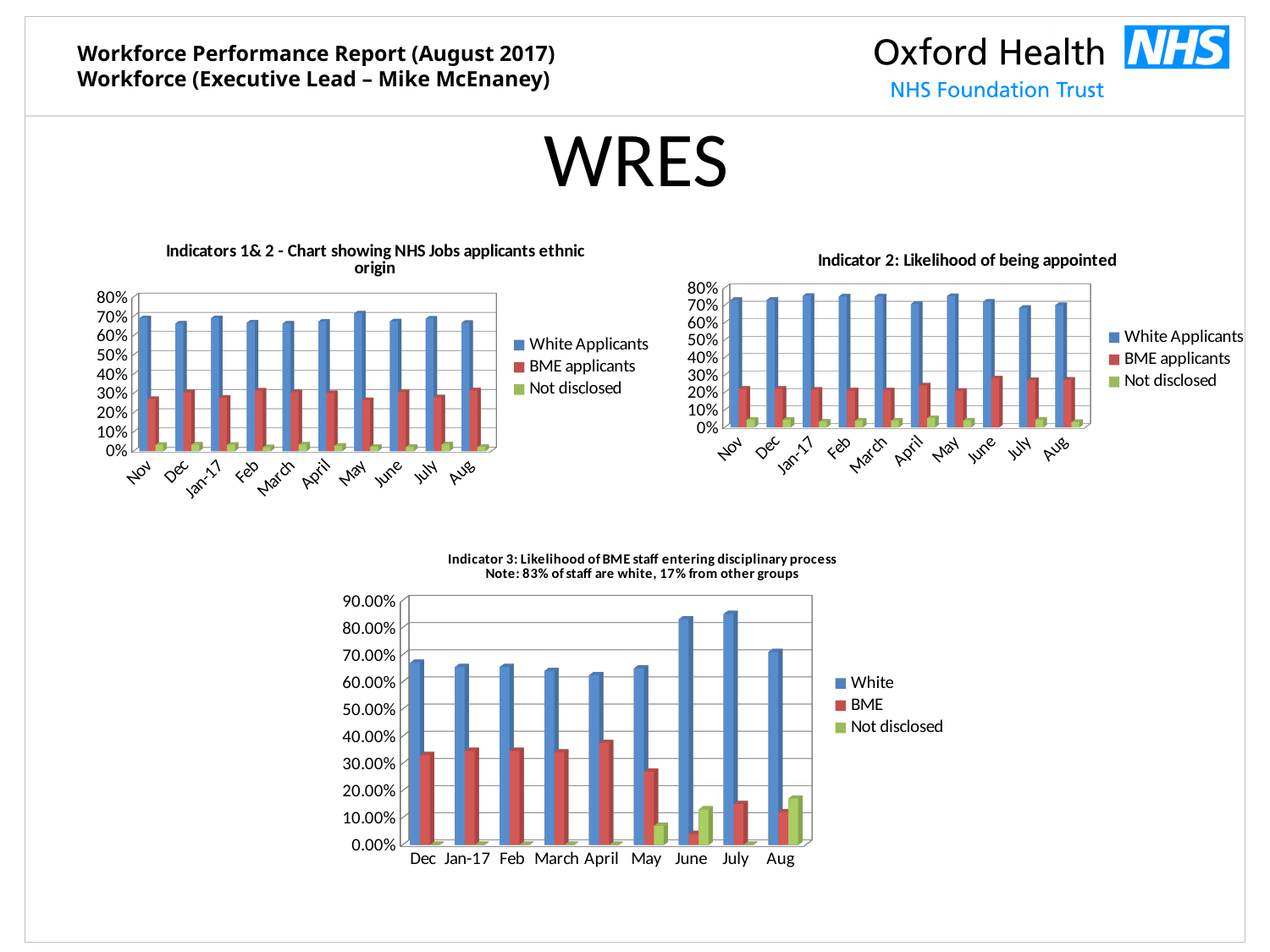
What kind of chart is 'Indicator 3: Likelihood of BME staff entering disciplinary process'? bar chart In the 'Indicator 3' chart, which month has the lowest BME value? June In the 'Indicator 2: Likelihood of being appointed' chart, is the value for White Applicants in Nov greater or less than 60%? greater In the 'Indicator 3' chart, is the Not disclosed value larger in June or in Aug? Aug How many months are shown on the x axis of the 'Indicators 1& 2 - Chart showing NHS Jobs applicants ethnic origin' chart? 10 In the 'Indicator 3' chart, is the value for BME in June greater or less than 10.00%? less In the 'Indicators 1& 2' chart, is the value for Not disclosed in Aug greater or less than 10%? less How many series does the legend list in the 'Indicator 2: Likelihood of being appointed' chart? 3 How many months are shown on the x axis of the 'Indicator 3: Likelihood of BME staff entering disciplinary process' chart? 9 What are the three legend entries in the 'Indicator 3' chart? White, BME, Not disclosed